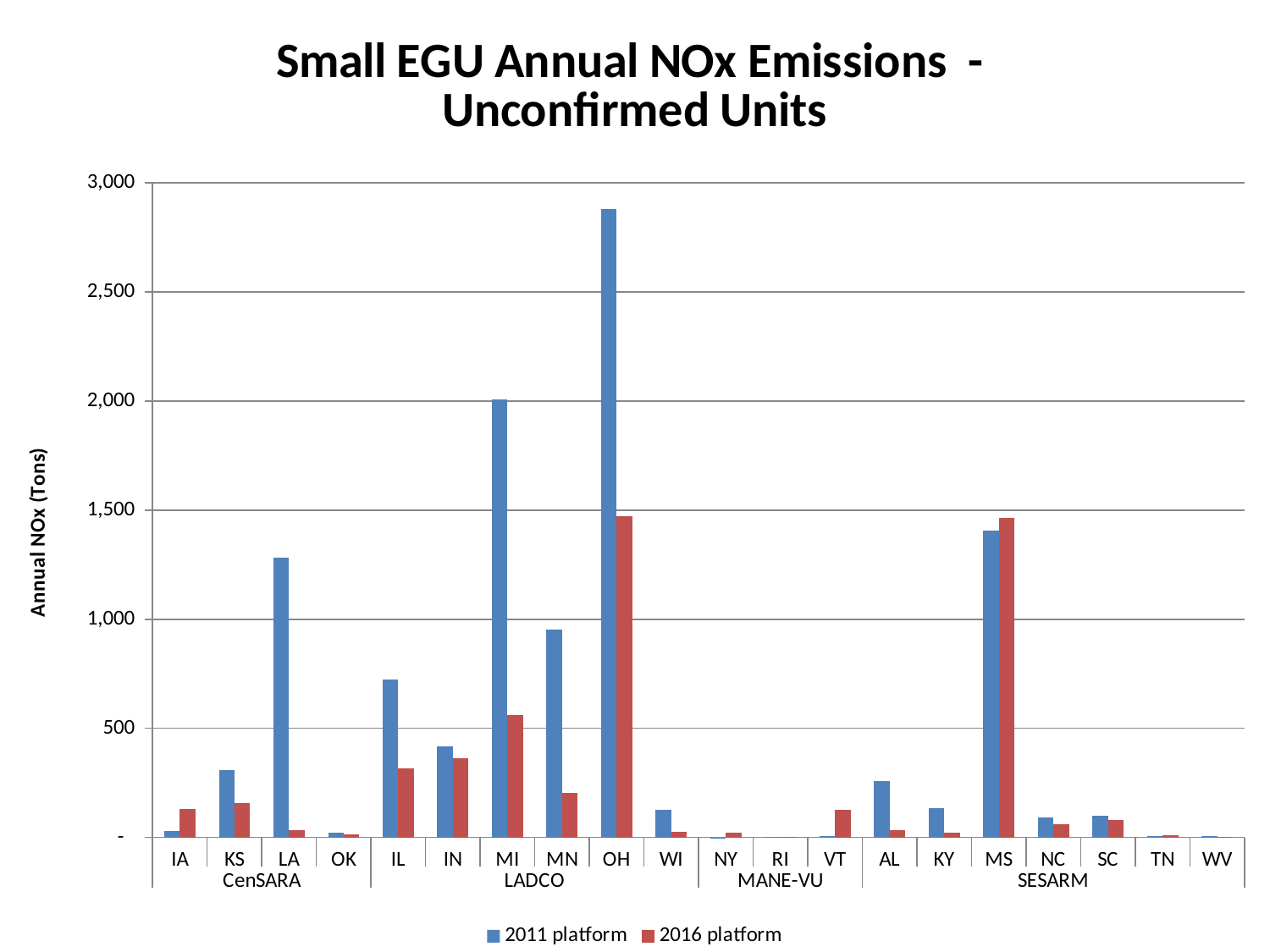
Which is larger, the 2011 platform value for OH or the 2011 platform value for MI? OH Which is larger for LA, the 2011 platform value or the 2016 platform value? 2011 platform What is the title of the y axis? Annual NOx (Tons) Which is larger for VT, the 2011 platform value or the 2016 platform value? 2016 platform Is the 2011 platform value for MN greater or less than 1,000? less How many series does the legend list? 2 Is the 2011 platform value for OH greater or less than 2,500? greater Is the 2011 platform value for LA greater or less than 1,000? greater Which state has the highest 2011 platform value? OH What kind of chart is shown on the slide? bar chart How many states are shown along the x axis? 20